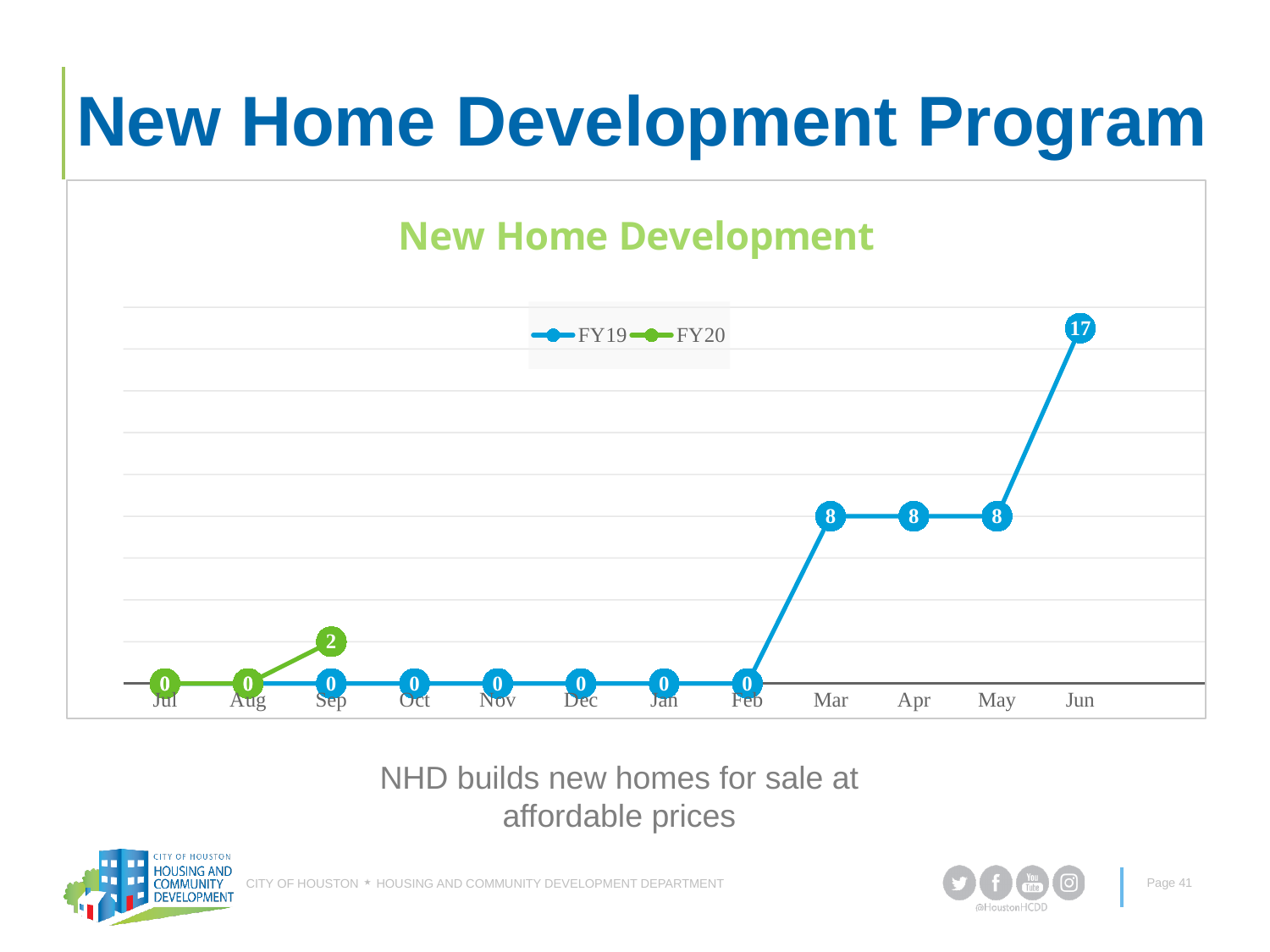
What kind of chart is shown on the slide? Line chart Which series are listed in the chart legend? FY19 and FY20 Which is larger, the FY19 value for Apr or the FY20 value for Sep? FY19 value for Apr What is the FY19 value for Mar? 8 What is the FY19 value for Jun? 17 In which month does the FY19 series reach its highest value? Jun Does the FY19 series rise or fall from Feb to Jun? Rise How many months are shown on the x axis? 12 How many series does the chart legend list? 2 What is the title of the chart? New Home Development What is the difference between the FY19 values for Jun and May? 9 What is the FY20 value for Sep? 2